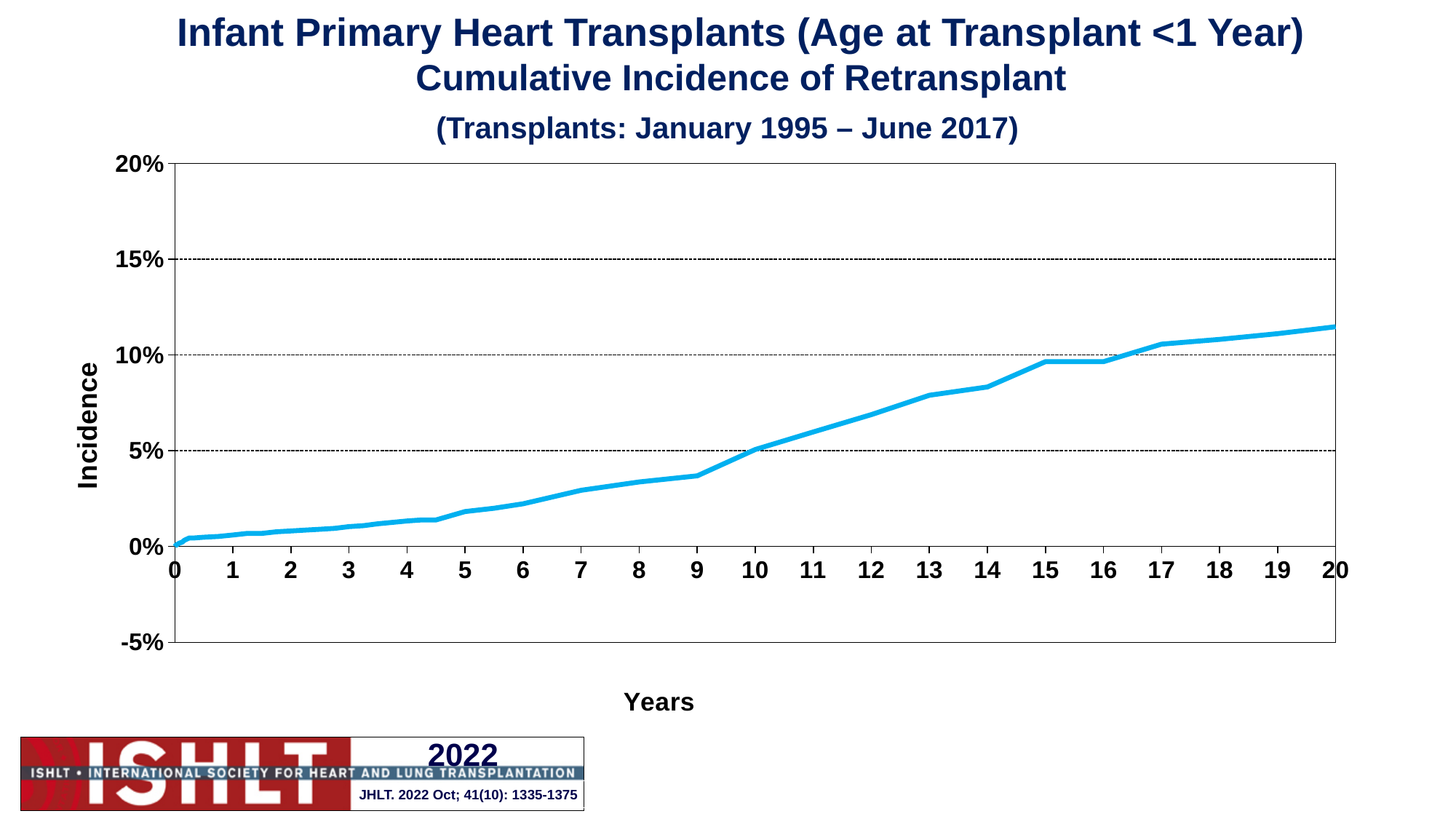
At which year on the x axis is the cumulative incidence lowest? 0 Is the cumulative incidence at 5 years greater or less than 5%? less At which year on the x axis is the cumulative incidence highest? 20 Which is larger, the cumulative incidence at 15 years or at 5 years? 15 years What is the label on the y axis of the chart? Incidence Does the cumulative incidence of retransplant rise or fall as the years increase? rise Is the cumulative incidence at 9 years greater or less than 5%? less Is the cumulative incidence at 13 years greater or less than 10%? less What kind of chart is shown on the slide? line chart What is the label on the x axis of the chart? Years